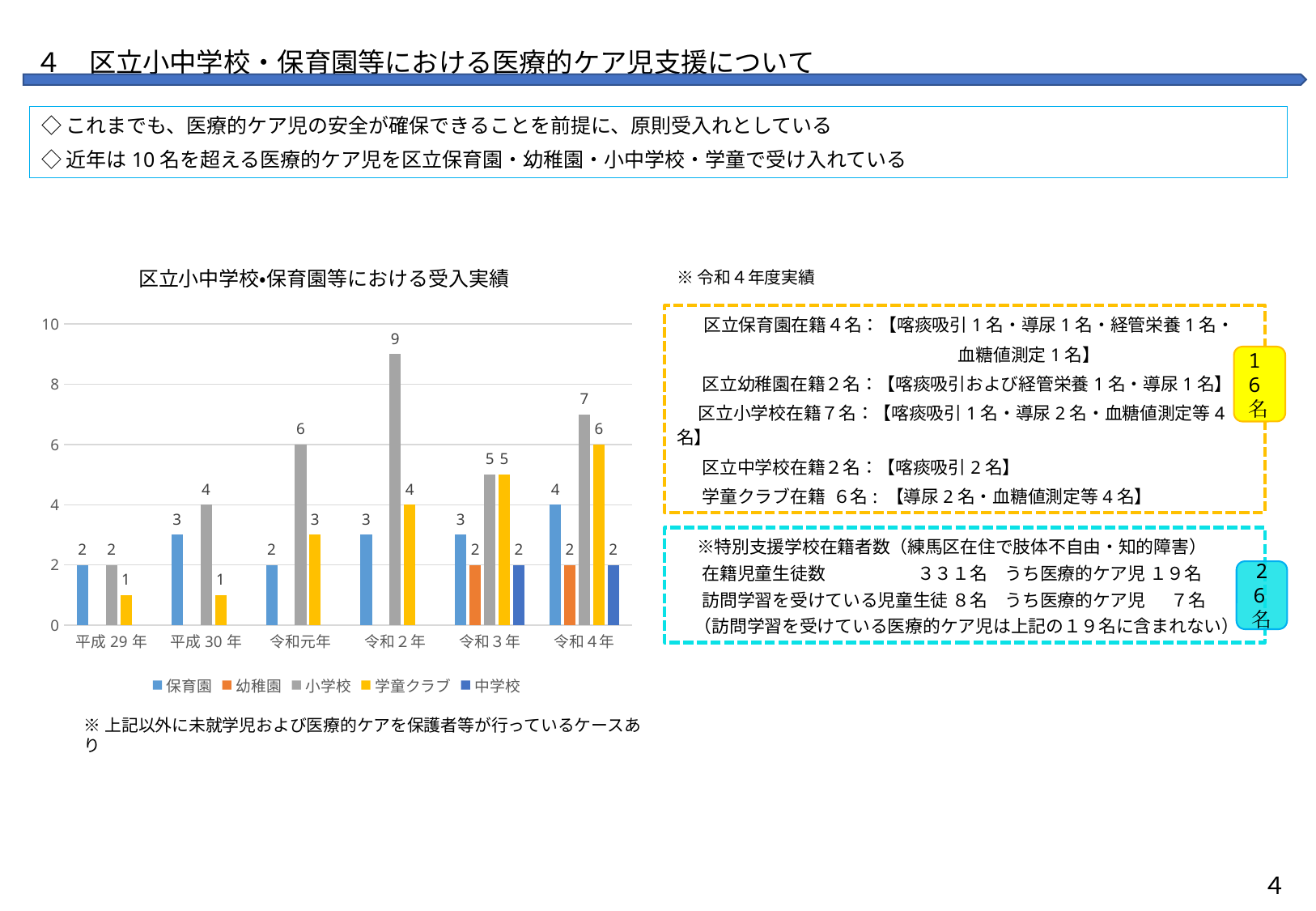
Which year has the lowest value for 学童クラブ? 平成29年 and 平成30年 (both 1) How many series does the chart legend list? 5 What is the value for 学童クラブ in 令和４年? 6 What kind of chart is shown on the slide? Bar chart Does the value for 保育園 rise or fall from 令和３年 to 令和４年? Rise In 令和３年, which is larger: the value for 小学校 or the value for 幼稚園? 小学校 What is the value for 保育園 in 平成30年? 3 What is the title of the chart? 区立小中学校•保育園等における受入実績 How many years are shown on the x axis of the chart? 6 Which year has the highest value for 小学校? 令和２年 What is the value for 小学校 in 令和２年? 9 What is the difference between the 小学校 value and the 保育園 value in 令和４年? 3